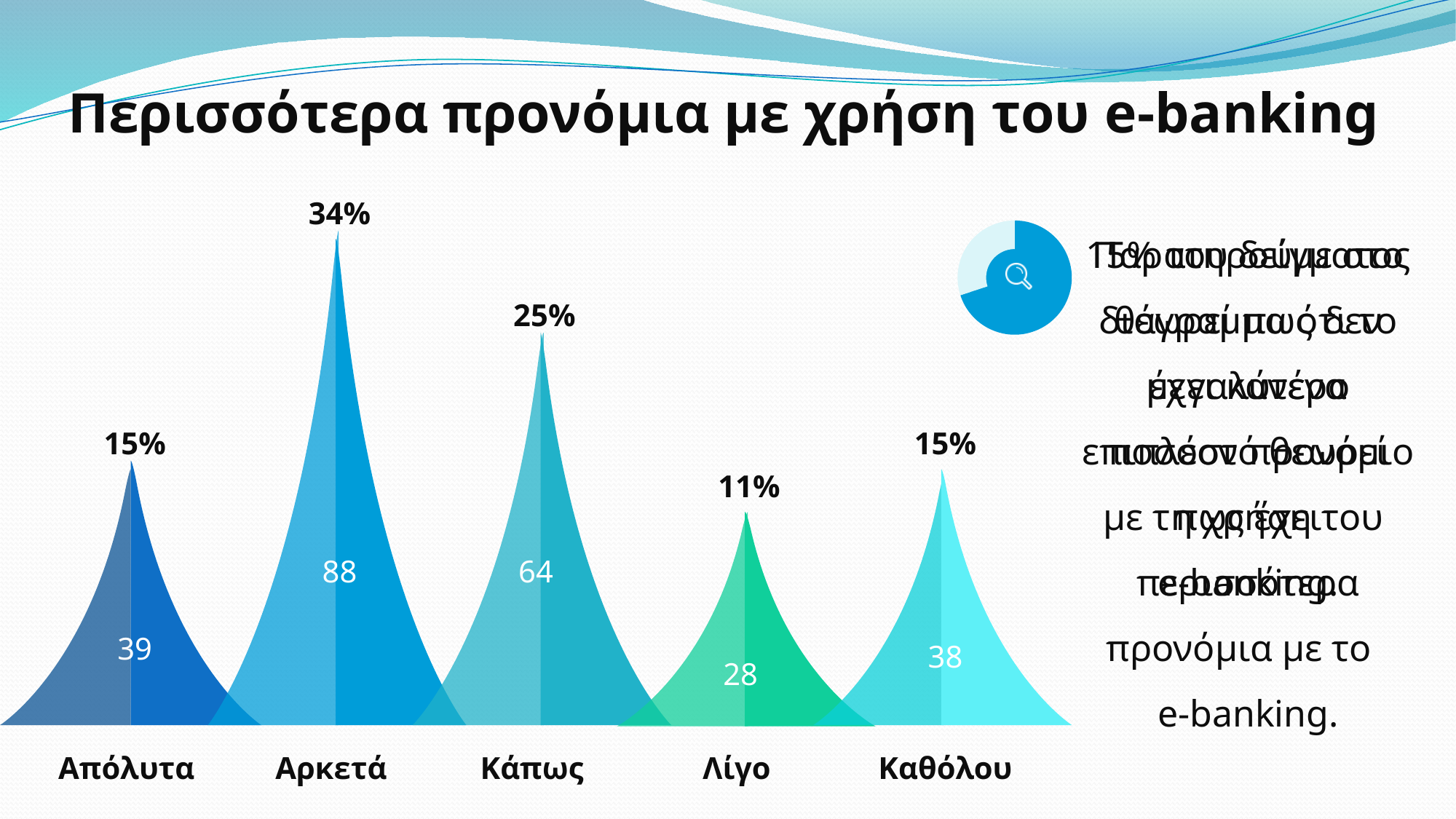
What percentage is shown above the category Κάπως? 25% What is the title of the slide containing the chart? Περισσότερα προνόμια με χρήση του e-banking Which has a larger count value, Κάπως or Καθόλου? Κάπως Do the values rise or fall from Αρκετά to Λίγο along the x axis? Fall What kind of chart is shown on the slide? Triangle (peak) chart Which category has the highest value? Αρκετά How many categories are shown on the x axis? 5 Which category has the lowest value? Λίγο What percentage is shown above the category Απόλυτα? 15% What is the difference between the count values for Αρκετά and Κάπως? 24 What is the count value for the category Αρκετά? 88 What is the count value for the category Λίγο? 28